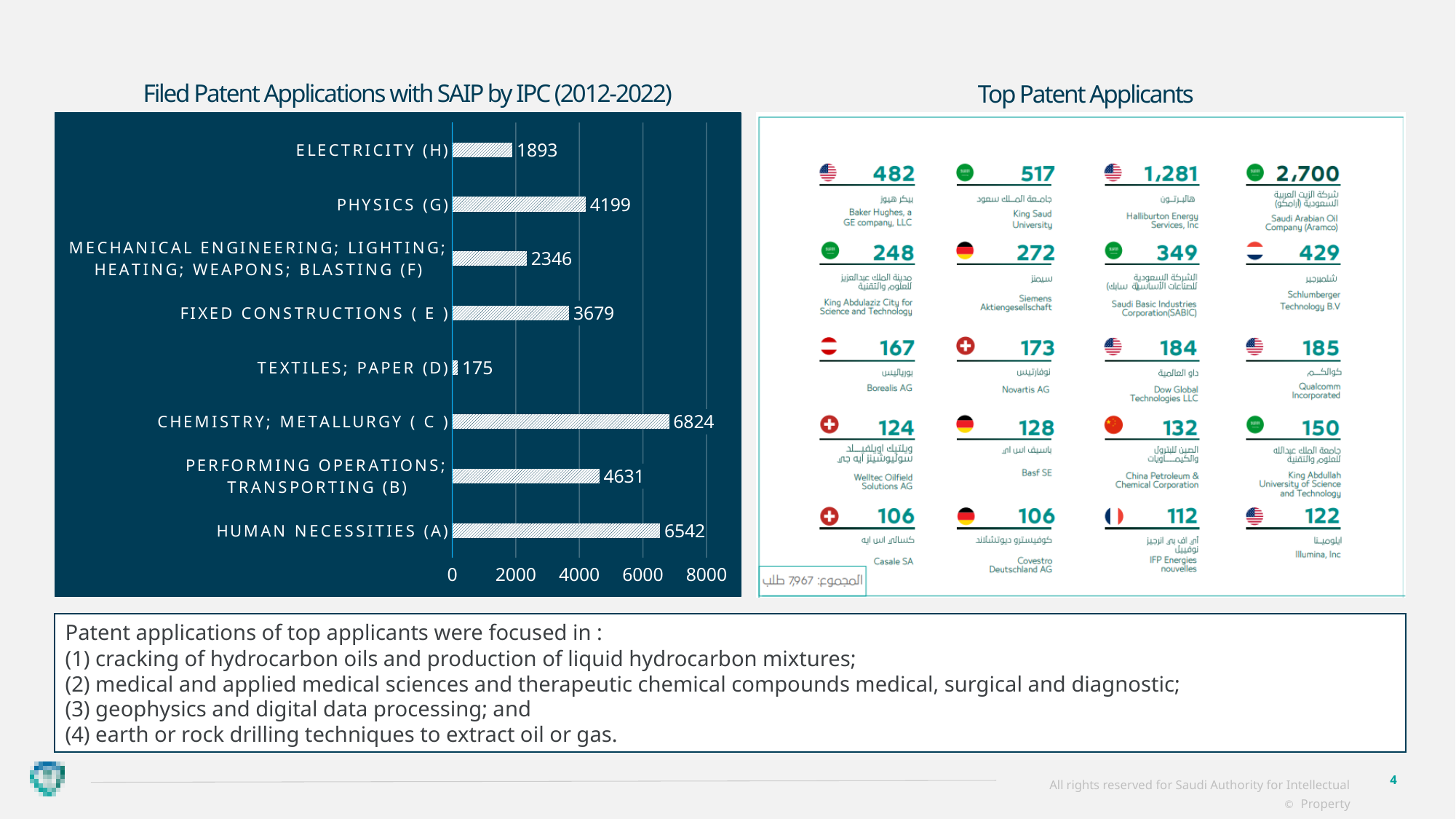
In the 'Filed Patent Applications with SAIP by IPC (2012-2022)' chart, what is the value for Physics (G)? 4199 In the 'Filed Patent Applications with SAIP by IPC (2012-2022)' chart, which IPC category has the lowest number of filed applications? Textiles; Paper (D) In the 'Filed Patent Applications with SAIP by IPC (2012-2022)' chart, which is larger: Fixed Constructions (E) or Mechanical Engineering; Lighting; Heating; Weapons; Blasting (F)? Fixed Constructions (E) In the 'Filed Patent Applications with SAIP by IPC (2012-2022)' chart, what is the value for Chemistry; Metallurgy (C)? 6824 In the 'Filed Patent Applications with SAIP by IPC (2012-2022)' chart, what is the difference between Chemistry; Metallurgy (C) and Human Necessities (A)? 282 How many IPC categories are shown in the 'Filed Patent Applications with SAIP by IPC (2012-2022)' chart? 8 What type of chart is 'Filed Patent Applications with SAIP by IPC (2012-2022)'? Bar chart In the 'Filed Patent Applications with SAIP by IPC (2012-2022)' chart, what is the difference between Physics (G) and Electricity (H)? 2306 In the 'Filed Patent Applications with SAIP by IPC (2012-2022)' chart, which IPC category has the highest number of filed applications? Chemistry; Metallurgy (C) In the 'Filed Patent Applications with SAIP by IPC (2012-2022)' chart, what is the value for Textiles; Paper (D)? 175 In the 'Top Patent Applicants' panel, how many patent applications are shown for Saudi Arabian Oil Company (Aramco)? 2,700 In the 'Filed Patent Applications with SAIP by IPC (2012-2022)' chart, is the value for Performing Operations; Transporting (B) greater or less than 4000? greater